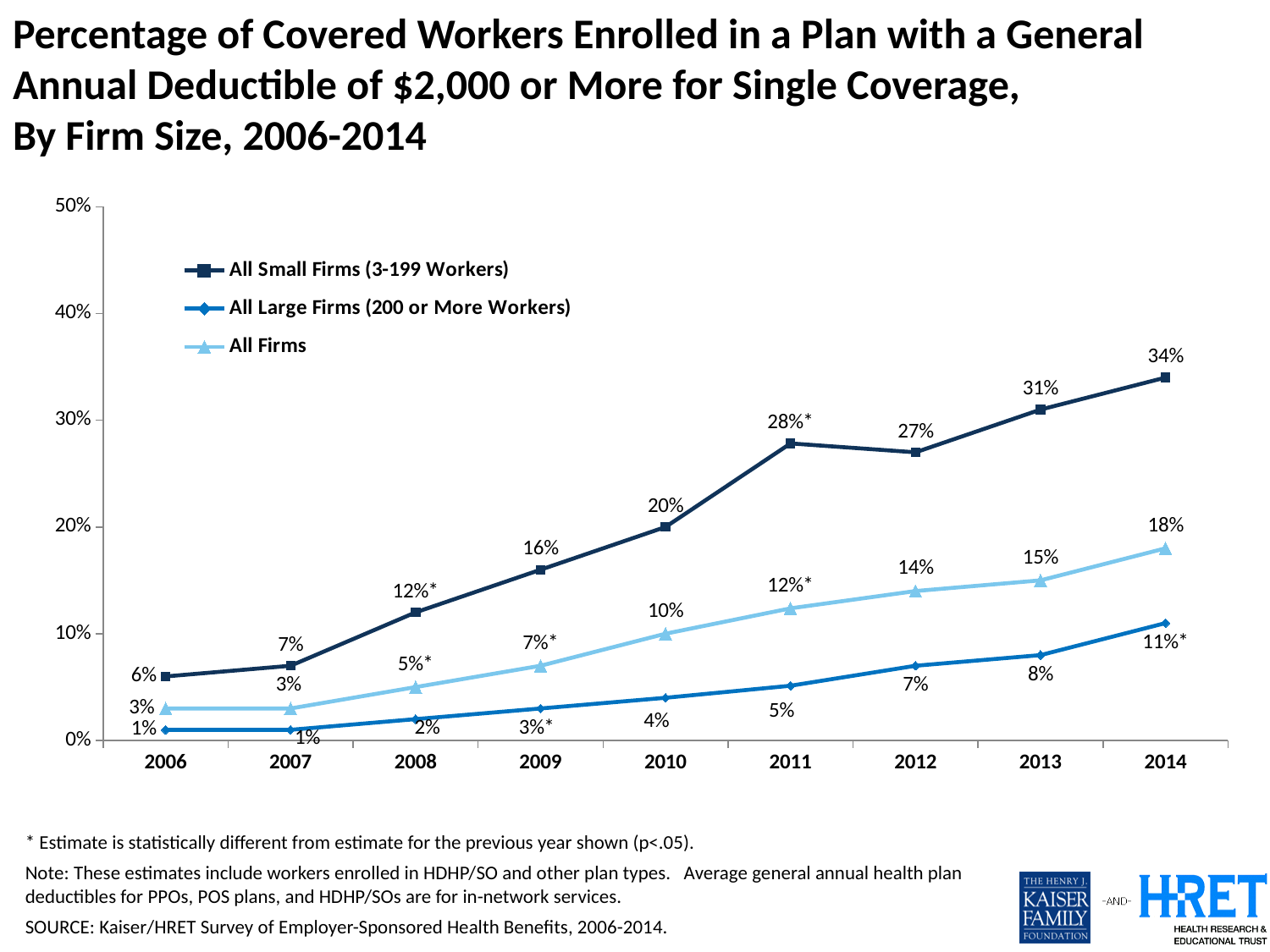
What is the value for All Large Firms (200 or More Workers) in 2013? 8% In which year is the value for All Small Firms (3-199 Workers) highest? 2014 Does the value for All Firms rise or fall from 2006 to 2014? rise What is the value for All Small Firms (3-199 Workers) in 2014? 34% Is the value for All Small Firms (3-199 Workers) in 2011 greater or less than 20%? greater In which year is the value for All Firms lowest? 2006 and 2007 What is the difference between the All Small Firms value and the All Large Firms value in 2012? 20% What is the value for All Firms in 2010? 10% Which is larger in 2013: the value for All Firms or the value for All Large Firms (200 or More Workers)? All Firms What type of chart is shown on the slide? line chart How many years are plotted along the x axis? 9 How many series does the legend list? 3